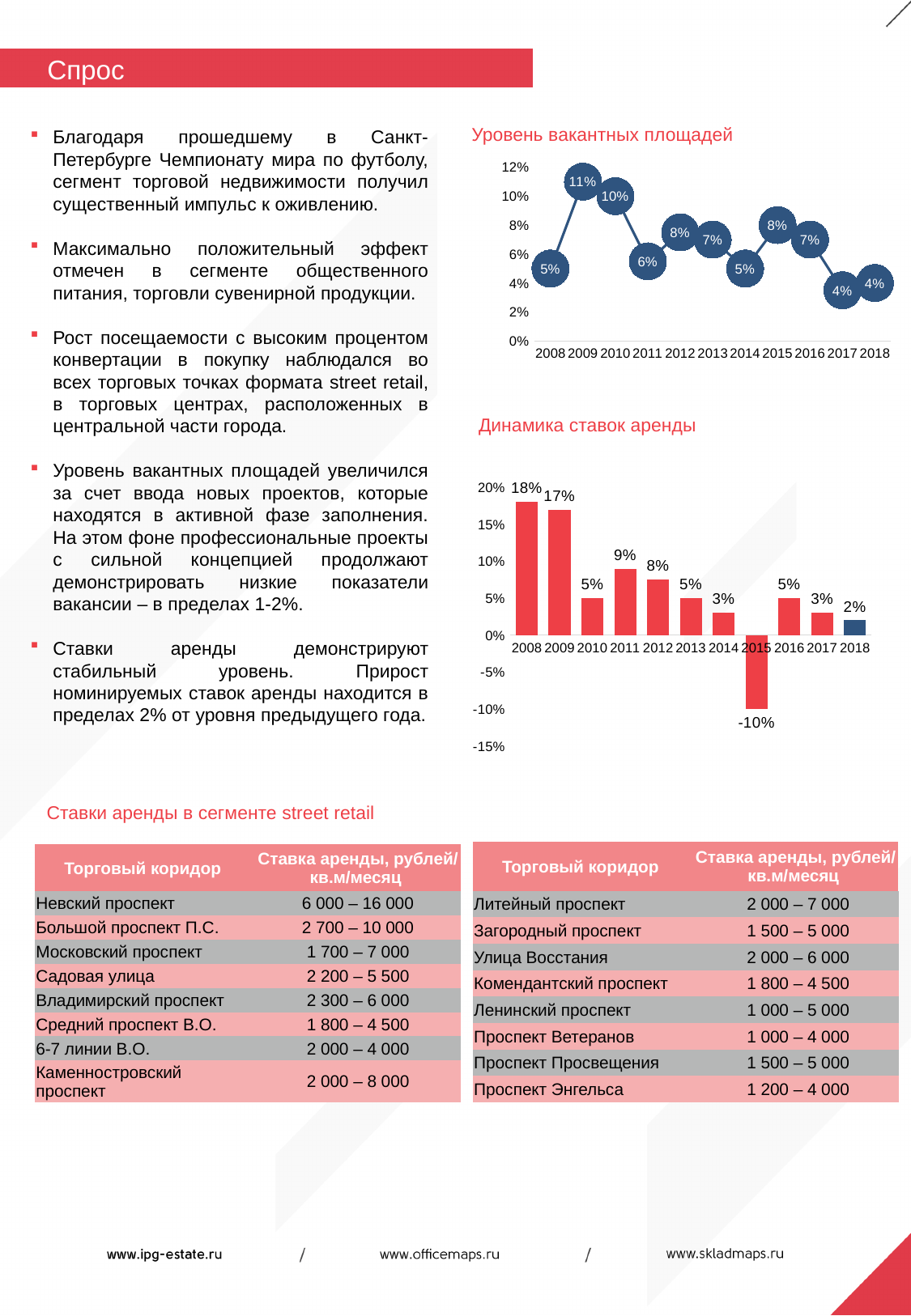
What kind of chart is 'Уровень вакантных площадей'? Line chart In the chart 'Динамика ставок аренды', which year has the lowest value? 2015 What kind of chart is 'Динамика ставок аренды'? Bar chart In the chart 'Уровень вакантных площадей', what is the value for 2009? 11% In the chart 'Уровень вакантных площадей', what is the difference between the values for 2009 and 2008? 6% In the chart 'Динамика ставок аренды', which year has the highest value? 2008 In the chart 'Динамика ставок аренды', which is larger, the value for 2011 or the value for 2012? 2011 In the chart 'Уровень вакантных площадей', which year has the highest value? 2009 In the chart 'Уровень вакантных площадей', what is the value for 2018? 4% In the chart 'Динамика ставок аренды', what is the value for 2015? -10% In the chart 'Уровень вакантных площадей', how many years are plotted? 11 In the chart 'Динамика ставок аренды', what is the difference between the values for 2008 and 2018? 16%